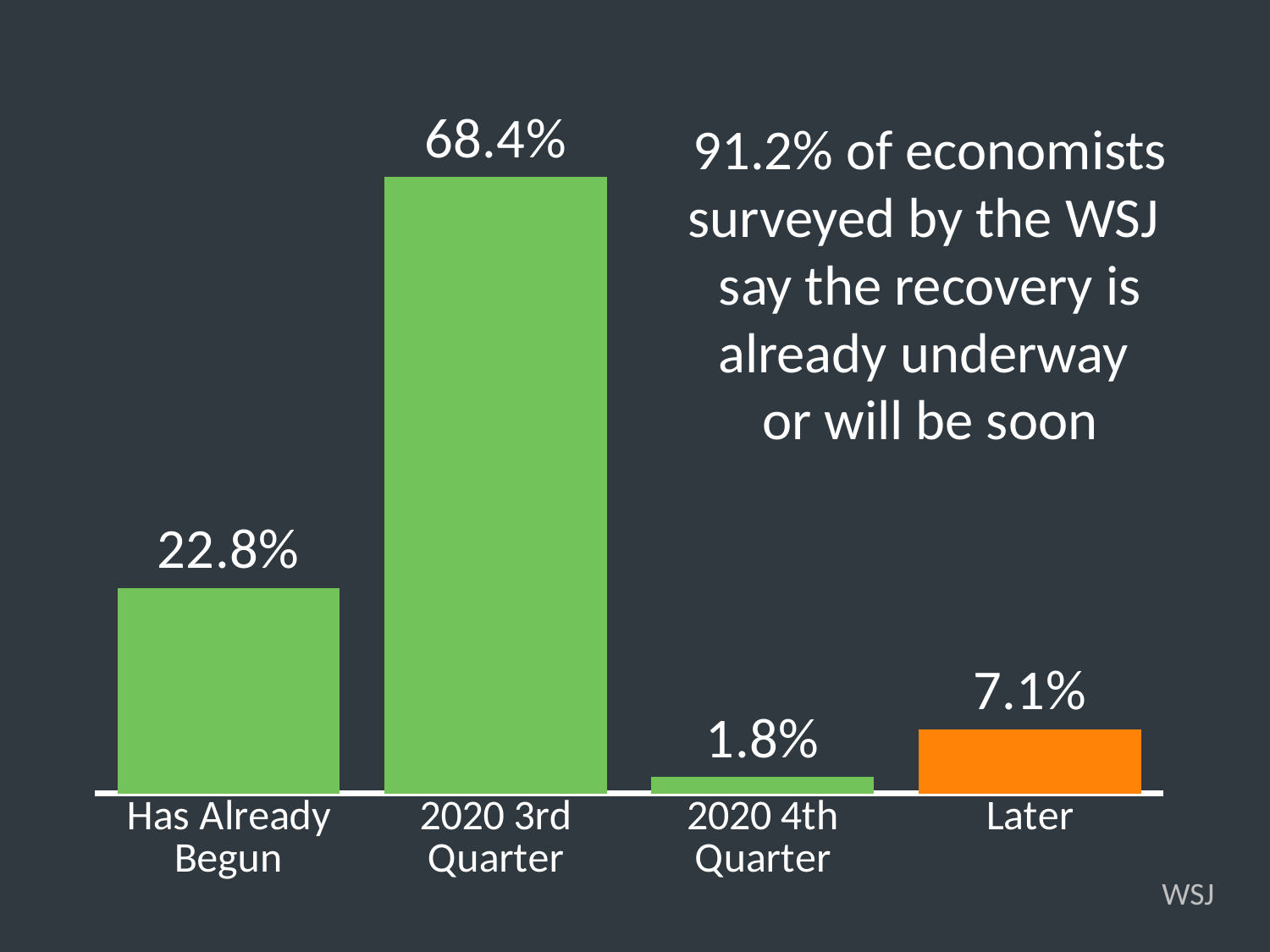
What is the value for "Later"? 7.1% What is the difference between the values for "2020 3rd Quarter" and "Has Already Begun"? 45.6% Which category has the lowest value? 2020 4th Quarter Which bar is coloured orange rather than green? Later What is the value for "Has Already Begun"? 22.8% How many categories are shown on the chart? 4 Which category has the highest value? 2020 3rd Quarter What kind of chart is shown on the slide? Bar chart What is the value for "2020 4th Quarter"? 1.8% What is the value for "2020 3rd Quarter"? 68.4% Which is larger, the value for "Later" or the value for "2020 4th Quarter"? Later What is the difference between the values for "Later" and "2020 4th Quarter"? 5.3%